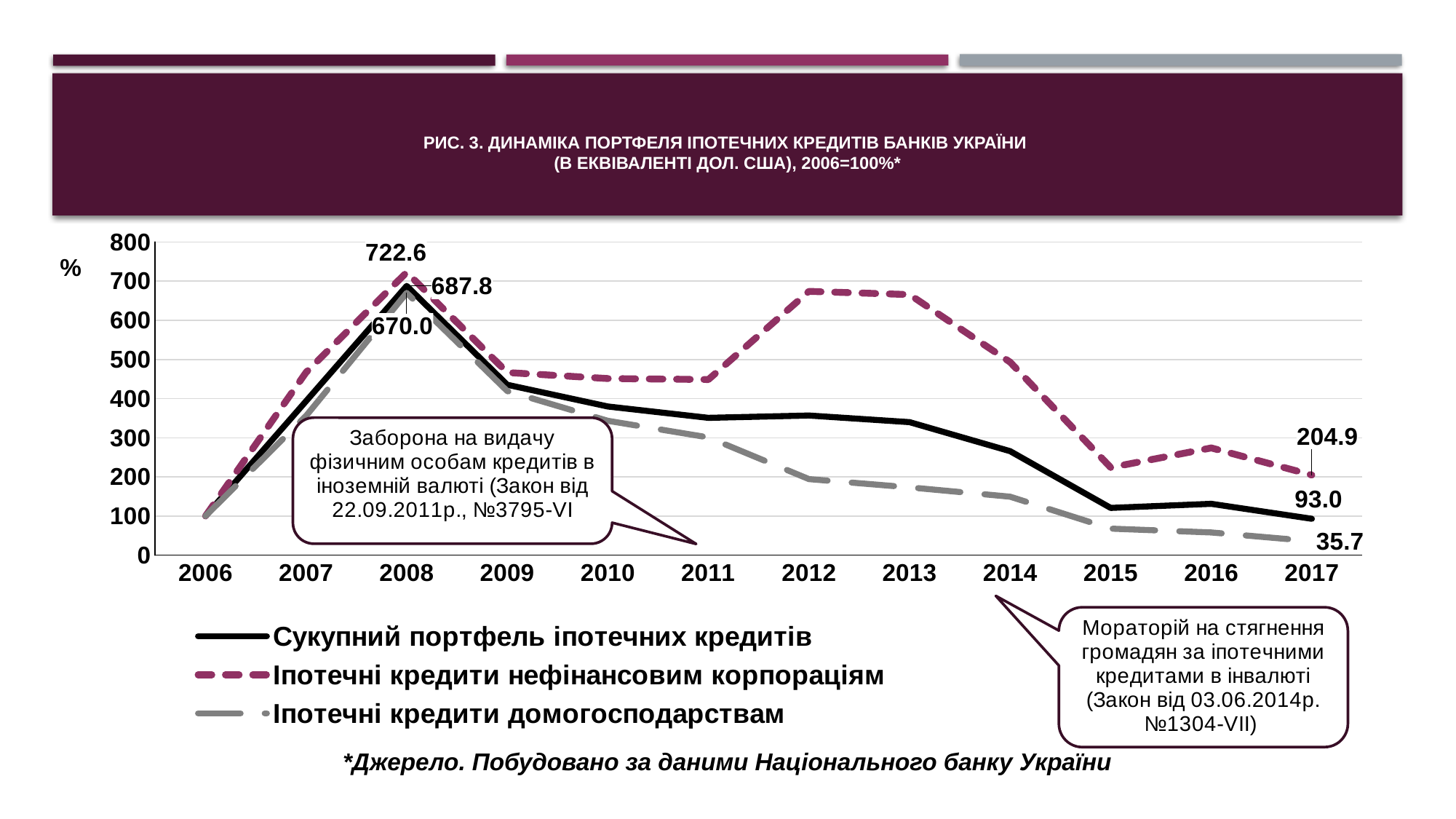
In which year does Сукупний портфель іпотечних кредитів reach its highest value? 2008 What kind of chart is shown on the slide? line chart What is the value for Сукупний портфель іпотечних кредитів in 2008? 687.8 What is the value for Сукупний портфель іпотечних кредитів in 2017? 93.0 What is the difference between the 2008 values for Іпотечні кредити нефінансовим корпораціям and Сукупний портфель іпотечних кредитів? 34.8 What is the difference between the 2017 values for Іпотечні кредити нефінансовим корпораціям and Іпотечні кредити домогосподарствам? 169.2 In 2017, which series has the larger value: Іпотечні кредити нефінансовим корпораціям or Сукупний портфель іпотечних кредитів? Іпотечні кредити нефінансовим корпораціям What is the value for Іпотечні кредити нефінансовим корпораціям in 2008? 722.6 How many years are shown on the x axis? 12 What is the value for Іпотечні кредити домогосподарствам in 2017? 35.7 Is the value for Іпотечні кредити нефінансовим корпораціям in 2012 greater or less than 600? greater How many series does the legend list? 3